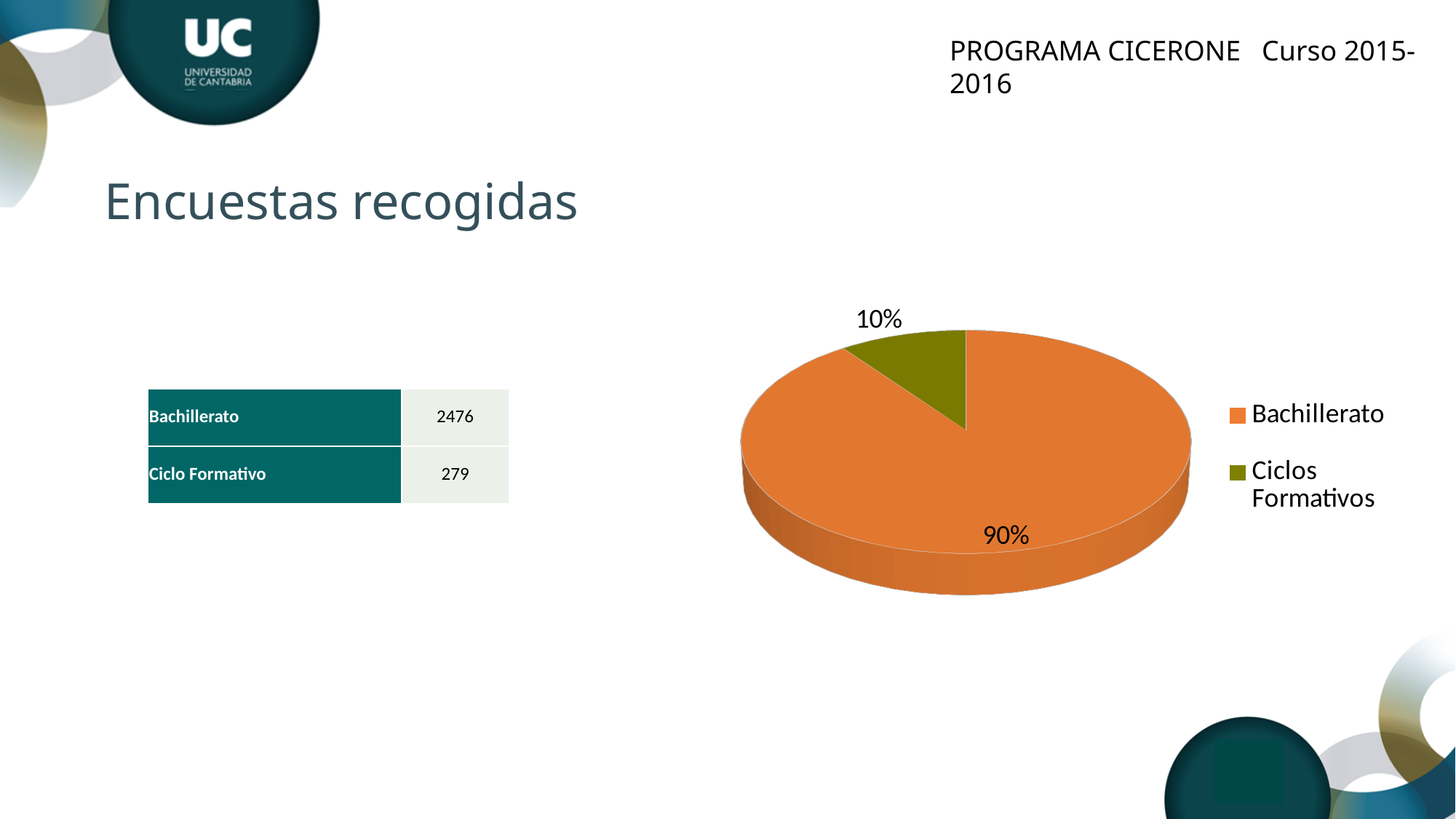
What kind of chart is shown on the slide? pie chart Which is larger, the Bachillerato slice or the Ciclos Formativos slice? Bachillerato What is the difference in percentage points between the Bachillerato and Ciclos Formativos slices? 80 percentage points What share of the pie does Ciclos Formativos represent? 10% What colour is the Ciclos Formativos slice in the pie chart? olive green Which slice of the pie is the largest? Bachillerato Which slice of the pie is the smallest? Ciclos Formativos How many slices does the pie chart have? 2 How many entries does the legend list? 2 What colour is the Bachillerato slice in the pie chart? orange What share of the pie does Bachillerato represent? 90%